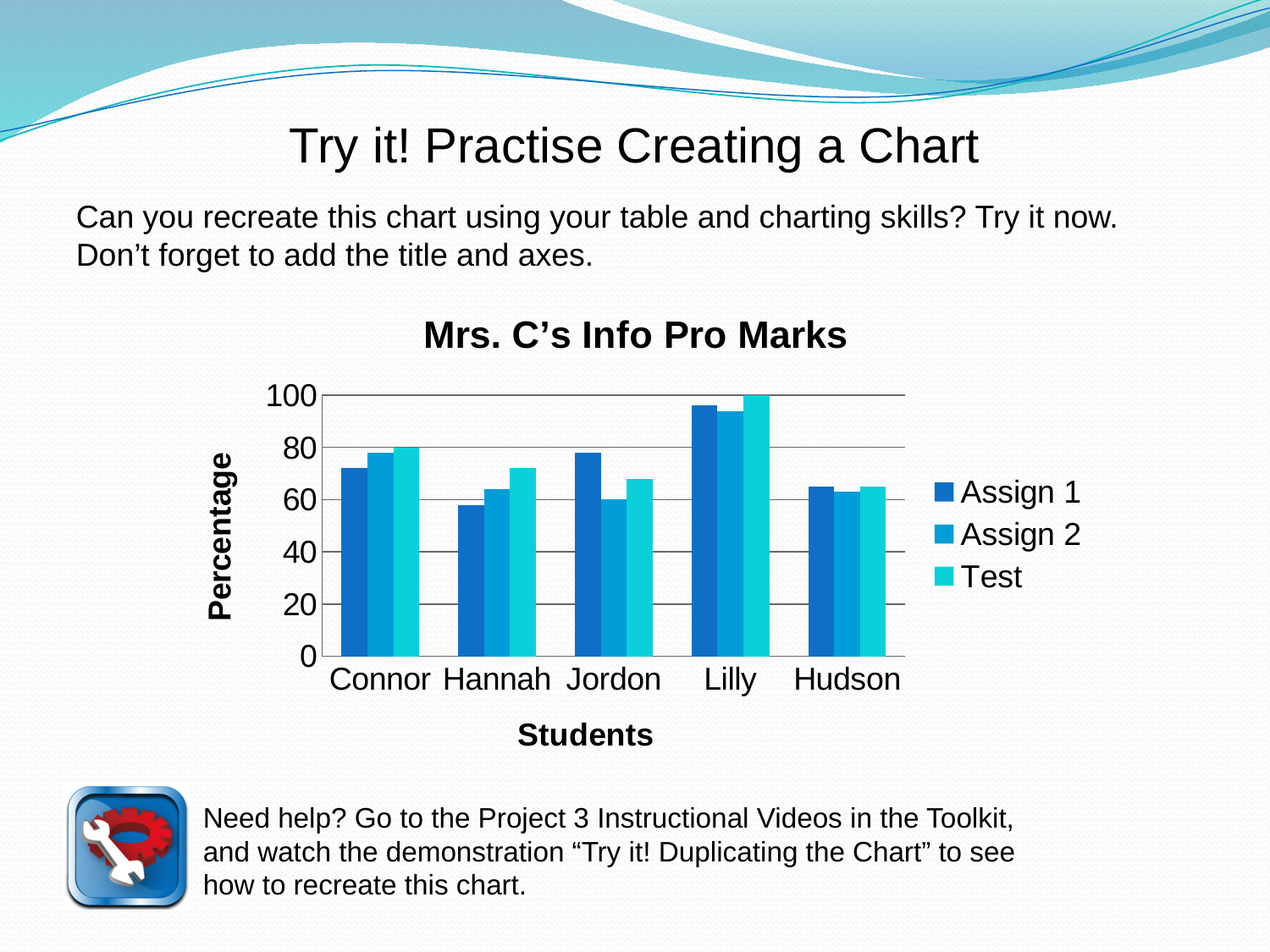
How many students are shown on the x axis? 5 What kind of chart is shown on the slide? bar chart How many series does the legend list? 3 Which student has the highest Test value? Lilly Which is larger, Lilly's Assign 1 value or Hudson's Assign 1 value? Lilly's Assign 1 value What is the label of the vertical axis? Percentage What is Lilly's Test value? 100 Is Lilly's Assign 1 value greater or less than 80? greater What is the title of the chart? Mrs. C's Info Pro Marks Which is larger for Hannah, the Assign 1 value or the Test value? Test Which student has the lowest Assign 1 value? Hannah